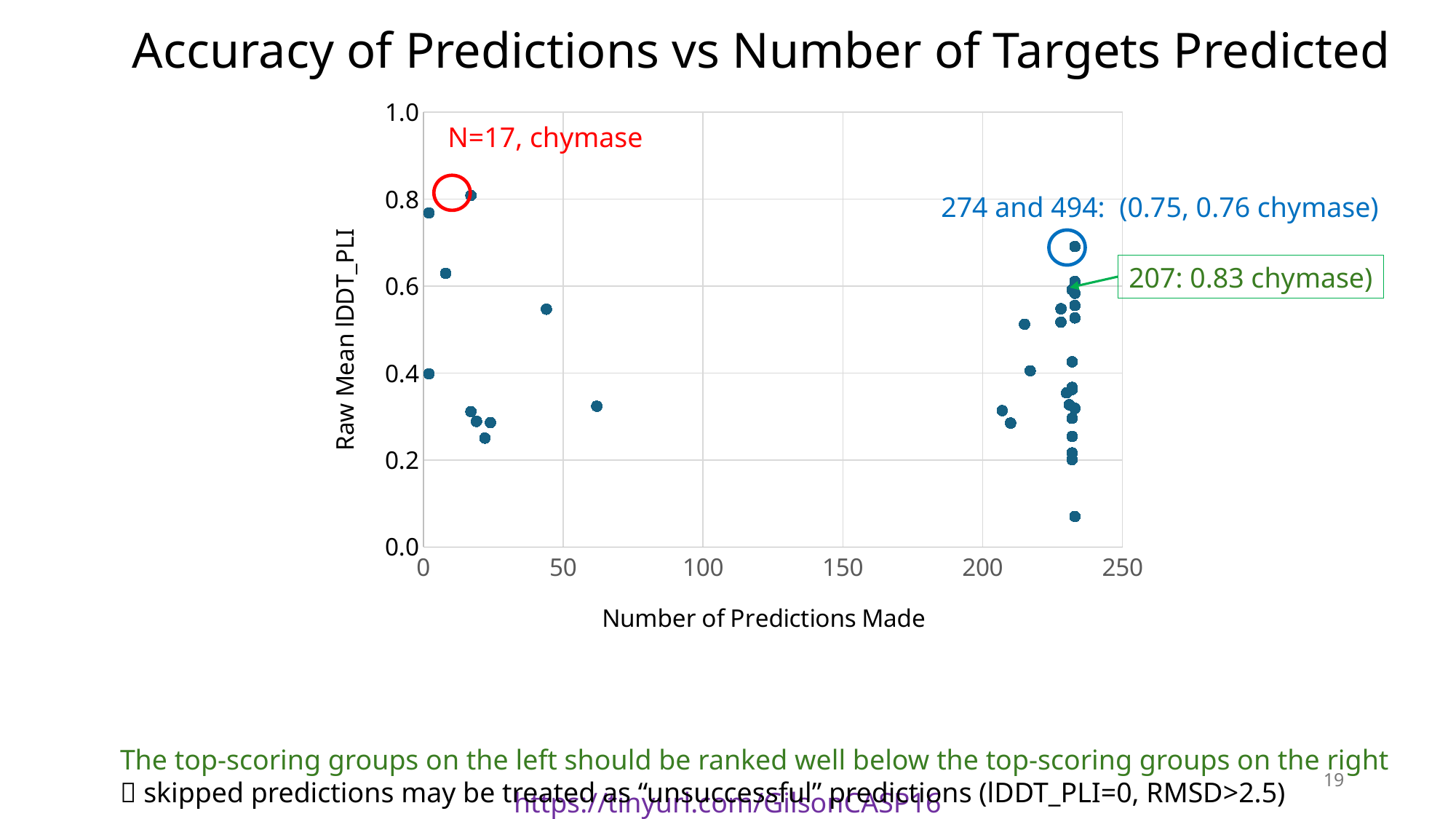
Is the lowest point near 230 predictions made greater or less than 0.2 on the y axis? less What is the maximum value shown on the x axis? 250 Is the value of the point circled in blue (274 and 494) greater or less than 0.6? greater Is the point at about 45 predictions made greater or less than 0.4 on the y axis? greater What is the label of the x axis? Number of Predictions Made What is the title of the chart? Accuracy of Predictions vs Number of Targets Predicted Which has the higher Raw Mean lDDT_PLI: the point circled in red or the point circled in blue? the point circled in red What kind of chart is shown on the slide? scatter plot